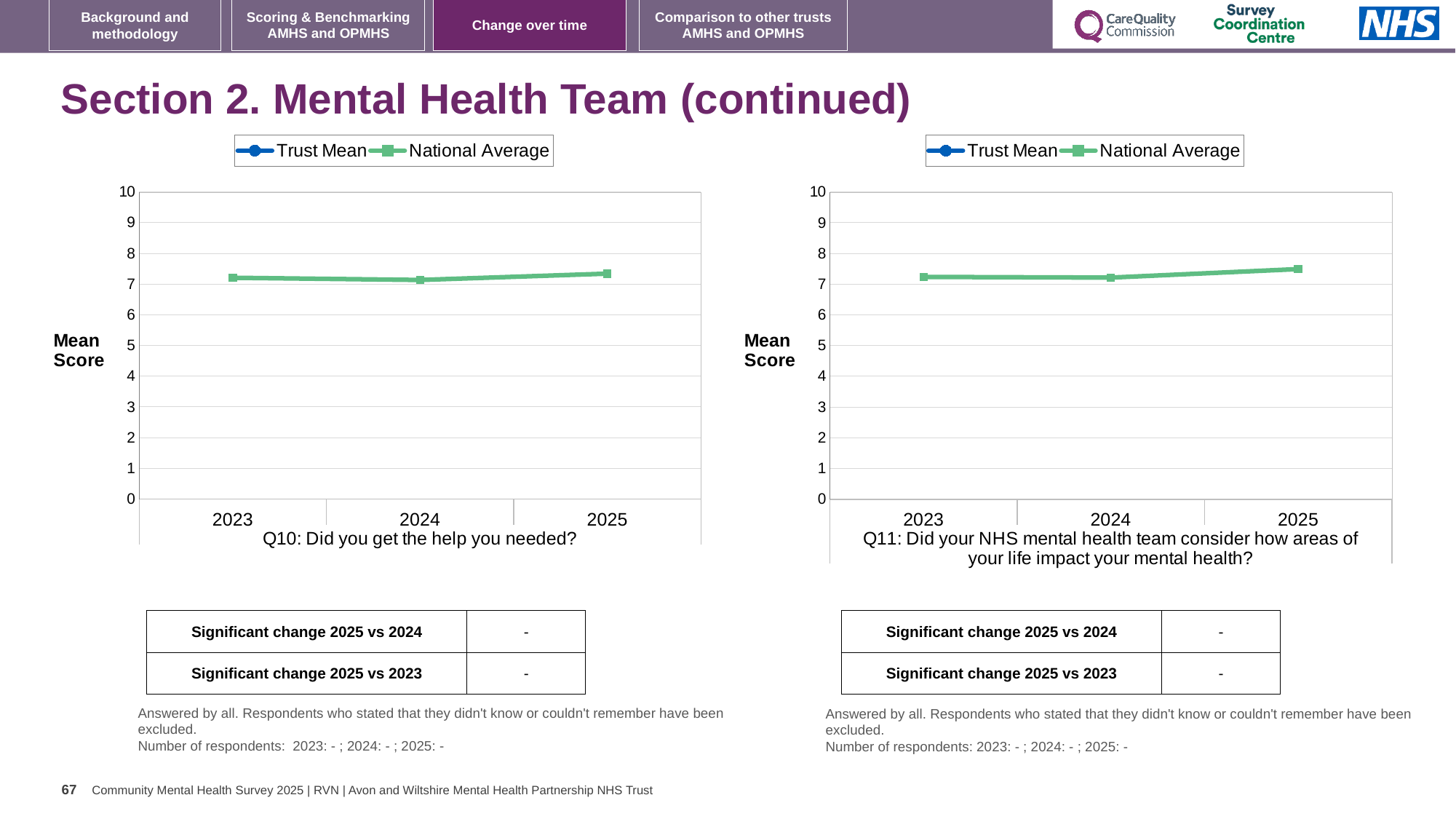
How many years are shown on the x axis of the Q10 chart on the left? 3 What is the question text shown beneath the x axis of the chart on the left? Q10: Did you get the help you needed? In the Q10 chart on the left, is the National Average value for 2025 greater or less than 5? greater In the Q10 chart on the left, does the National Average line rise or fall from 2024 to 2025? rise In the Q11 chart on the right, which year has the higher National Average value, 2023 or 2025? 2025 In the Q11 chart on the right, does the National Average line rise or fall from 2024 to 2025? rise What is the maximum value shown on the y axis of the Q10 chart on the left? 10 What kind of chart is the Q10 chart on the left? line chart In the Q11 chart on the right, is the National Average value for 2025 greater or less than 6? greater How many series does the legend of the Q11 chart on the right list? 2 In the Q11 chart on the right, is the National Average value for 2023 greater or less than 8? less